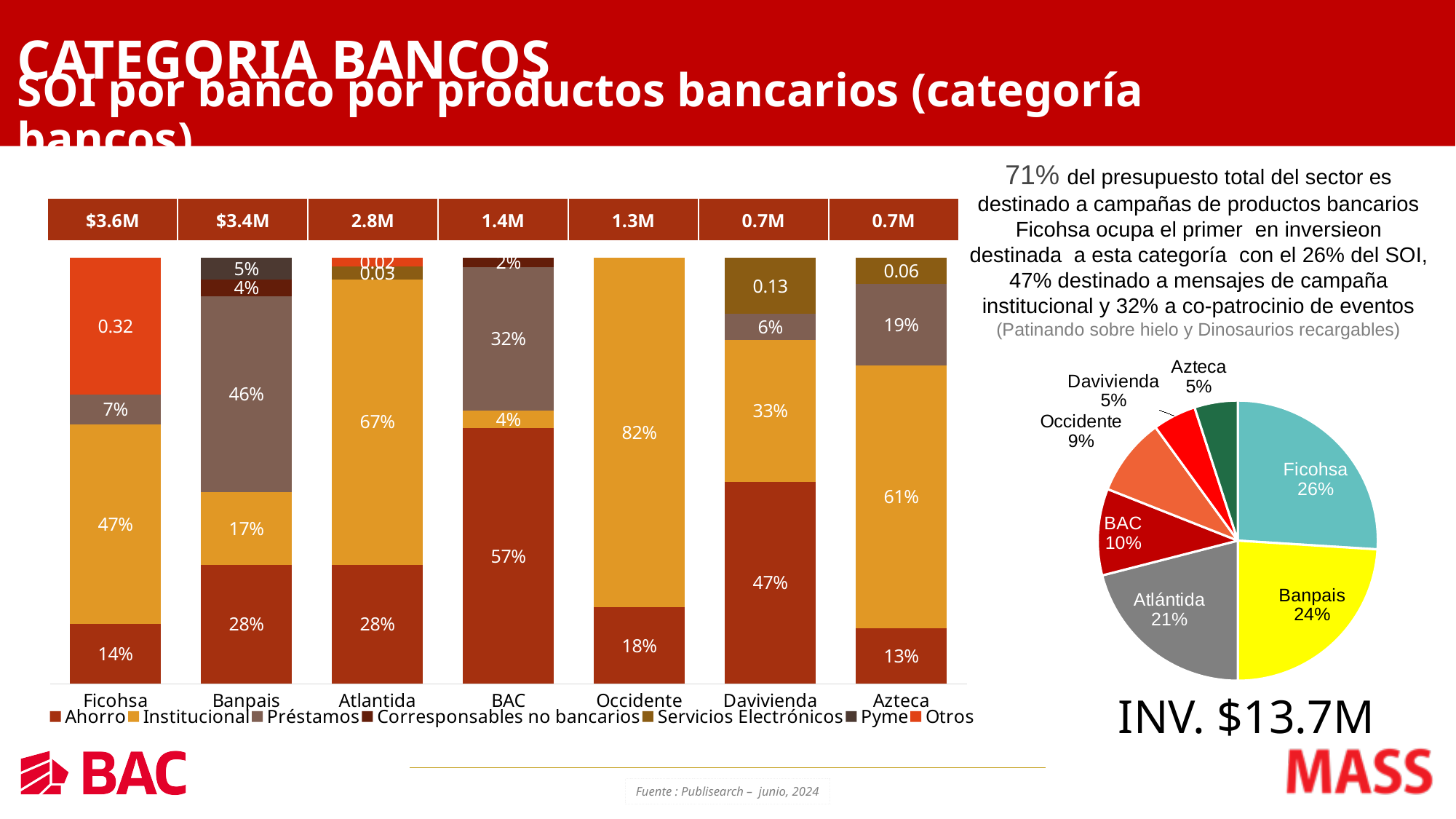
In the stacked bar chart, is the Institucional share larger for Azteca or for Davivienda? Azteca In the stacked bar chart, what is the Institucional share for Occidente? 82% In the stacked bar chart, which bank has the lowest Ahorro share? Azteca In the pie chart, which bank has the largest slice? Ficohsa In the stacked bar chart, what is the Ahorro share for BAC? 57% In the stacked bar chart, which bank has the highest Ahorro share? BAC In the stacked bar chart, what is the Préstamos share for Banpais? 46% What type of chart is the chart on the right side of the slide? Pie chart In the stacked bar chart, what is the difference between the Institucional shares of Atlantida and Banpais? 50% How many banks are shown on the x axis of the stacked bar chart? 7 In the pie chart, what share does Atlántida have? 21% How many series does the legend of the stacked bar chart list? 7